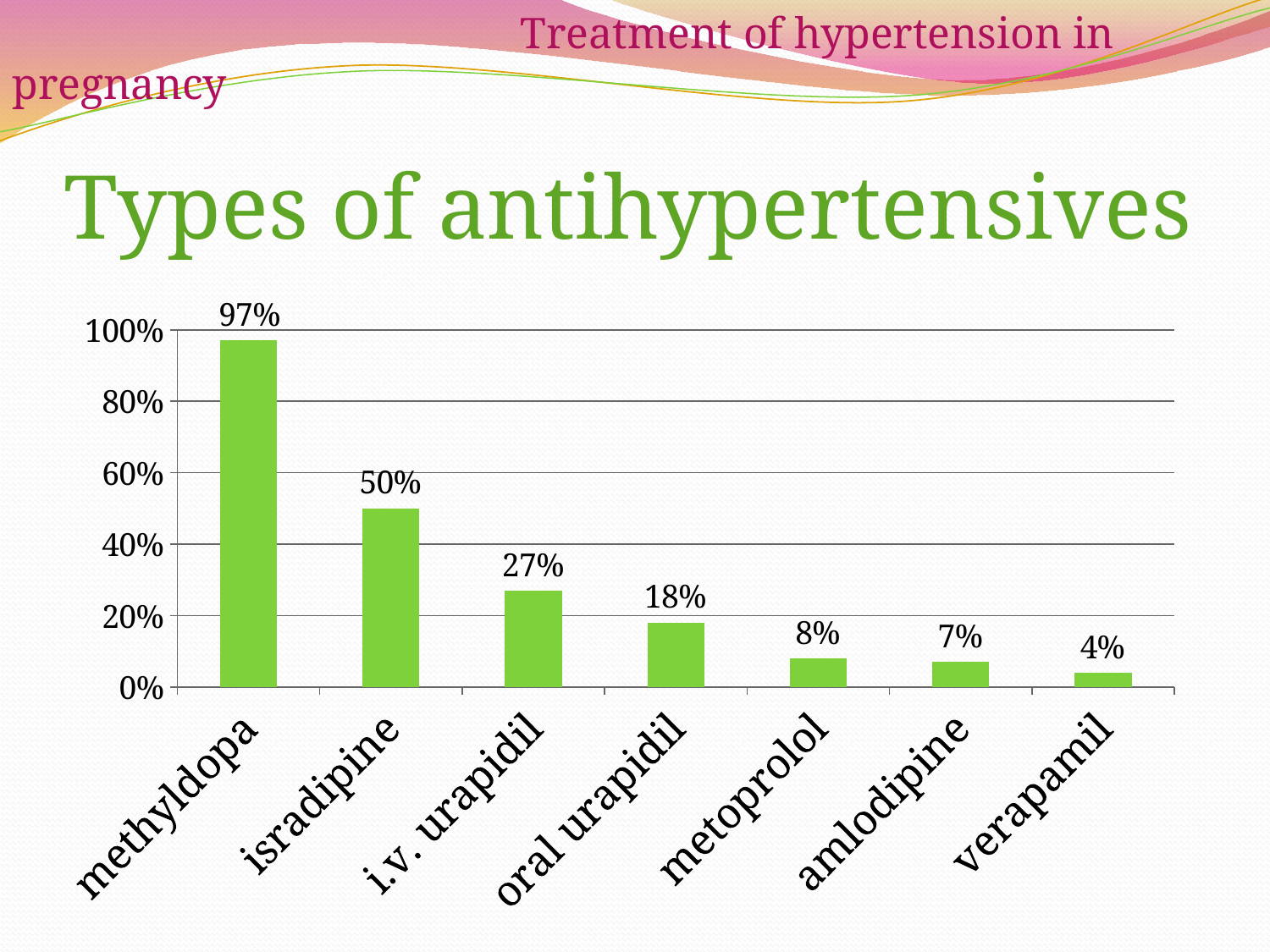
What is the value for methyldopa? 97% Do the values rise or fall from left to right along the x axis? fall What is the difference between the values for i.v. urapidil and oral urapidil? 9% What is the value for oral urapidil? 18% Which antihypertensive has the highest value? methyldopa What is the value for isradipine? 50% What is the value for verapamil? 4% How many antihypertensives are shown on the chart? 7 What is the difference between the values for methyldopa and isradipine? 47% What kind of chart is shown on the slide? bar chart Which has a larger value, metoprolol or amlodipine? metoprolol Which antihypertensive has the lowest value? verapamil